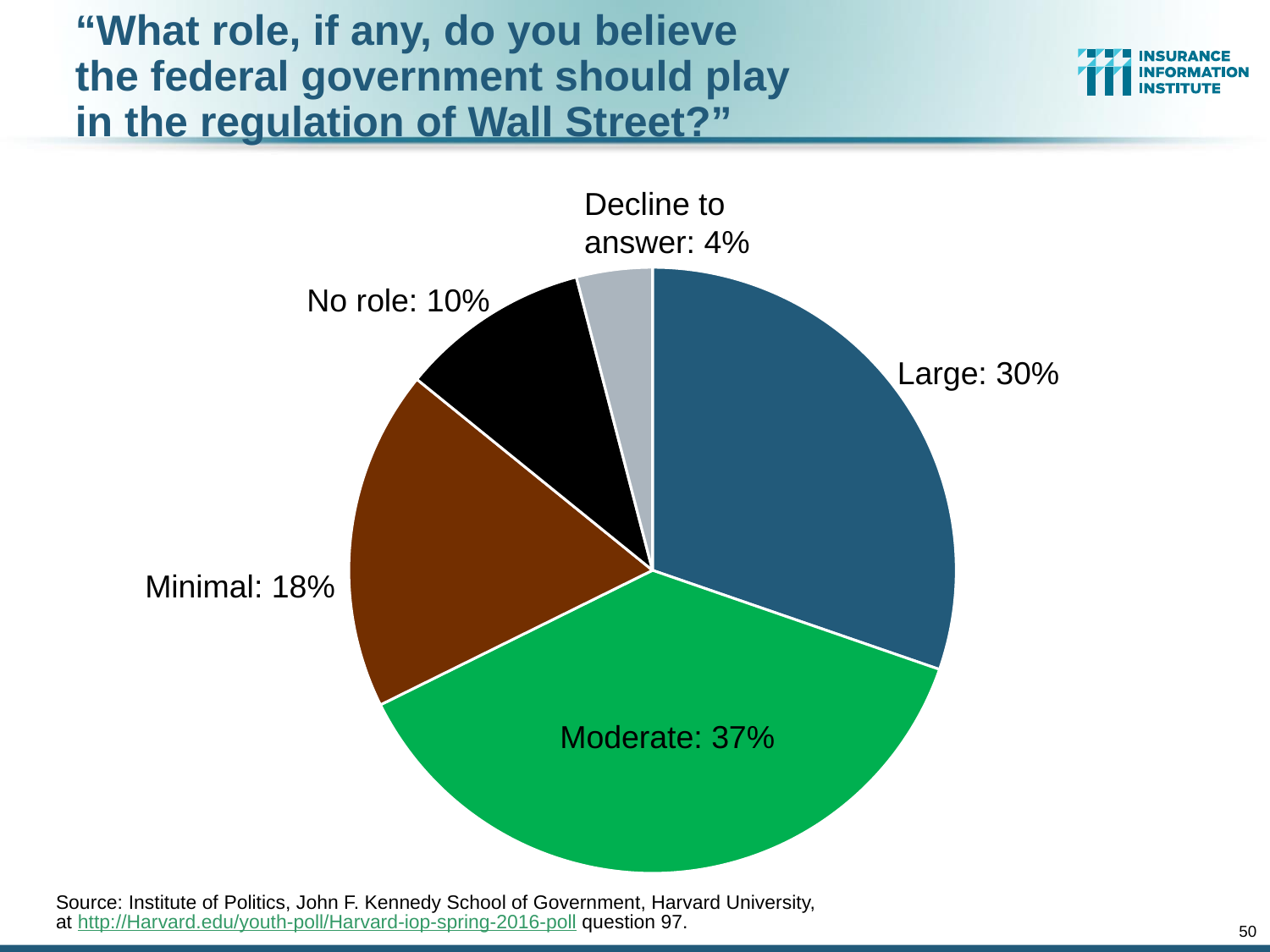
What percentage of respondents chose 'Minimal'? 18% What percentage of respondents chose 'Moderate'? 37% Which response has the smallest share of the pie? Decline to answer Which is larger, the share for 'Minimal' or the share for 'No role'? Minimal What share of respondents said the federal government should play a large role in regulating Wall Street? 30% What colour is the 'Moderate' slice of the pie? green What is the difference in percentage points between the 'Moderate' and 'Large' responses? 7 What percentage of respondents said 'No role'? 10% What kind of chart is shown on the slide? pie chart What percentage of respondents declined to answer? 4% How many slices does the pie chart have? 5 Which response has the largest share of the pie? Moderate